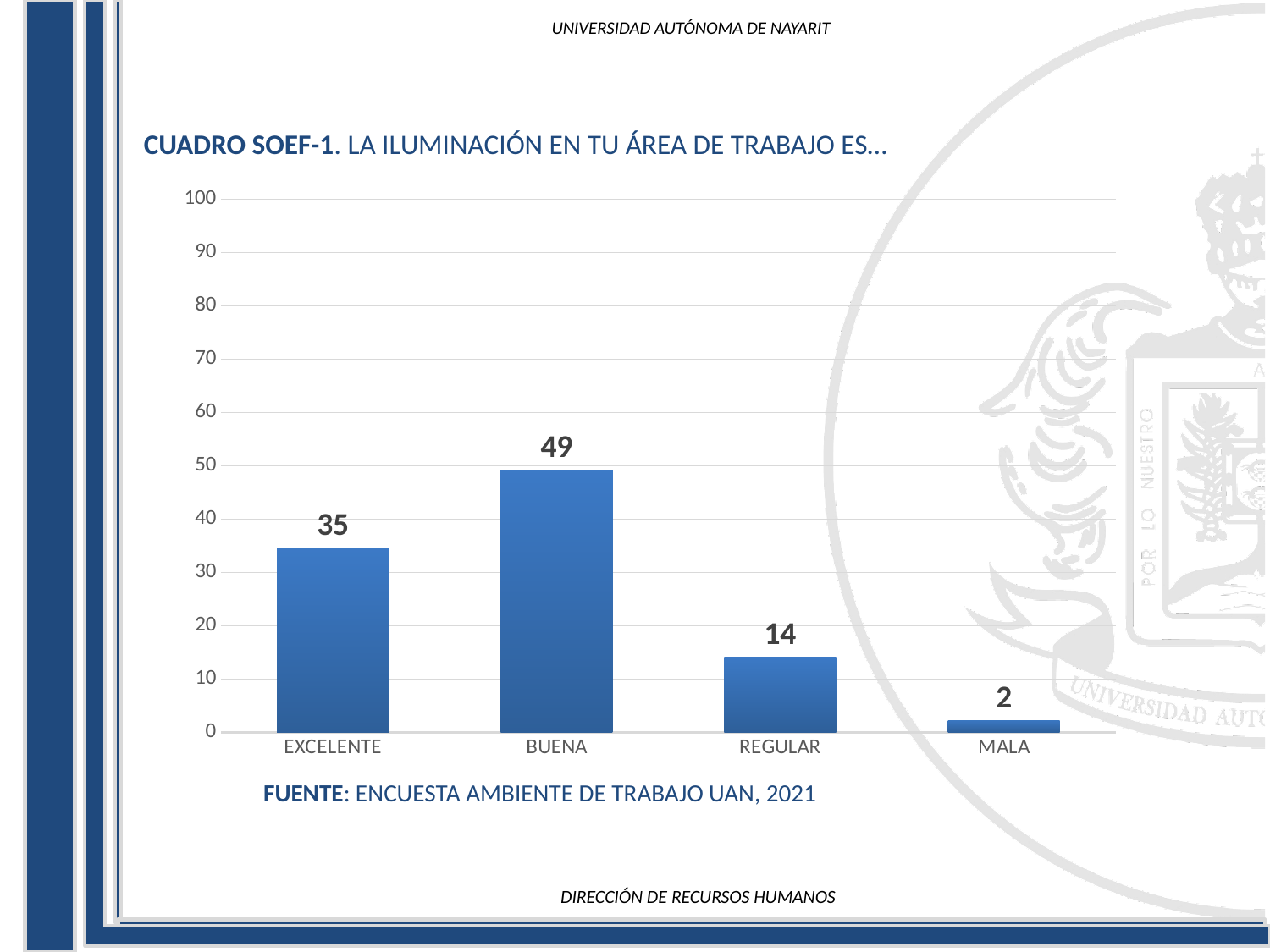
What is the difference between the values for BUENA and EXCELENTE? 14 What kind of chart is shown on the slide? bar chart What is the difference between the values for REGULAR and MALA? 12 What is the value for REGULAR? 14 Is the value for BUENA greater or less than 40? greater What is the value for MALA? 2 How many categories are shown on the x axis? 4 What is the value for EXCELENTE? 35 What is the value for BUENA? 49 Which is larger, the value for EXCELENTE or the value for REGULAR? EXCELENTE Which category has the lowest value? MALA Which category has the highest value? BUENA